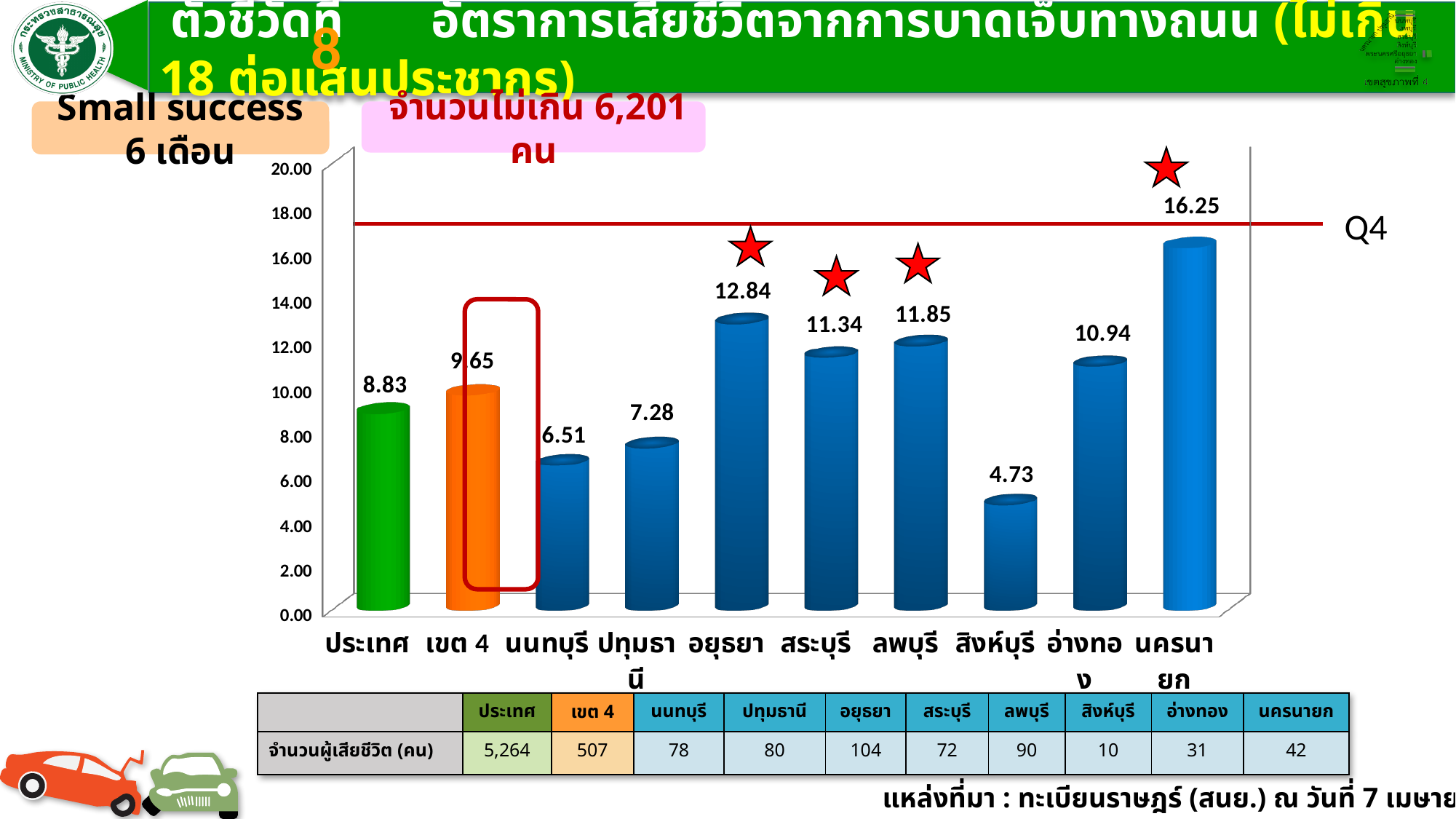
What label is written next to the horizontal red line on the chart? Q4 How many categories are plotted on the x axis of the chart? 10 What is the difference between the values for อยุธยา and นนทบุรี? 6.33 What type of chart is shown on the slide? bar chart What is the value shown for เขต 4? 9.65 Which category has the highest value in the chart? นครนายก What is the value shown for สิงห์บุรี? 4.73 What is the difference between the values for เขต 4 and ประเทศ? 0.82 Is the value for อ่างทอง greater or less than 10.00? greater What is the value shown for นครนายก? 16.25 Which has a larger value, ลพบุรี or สระบุรี? ลพบุรี Which category has the lowest value in the chart? สิงห์บุรี